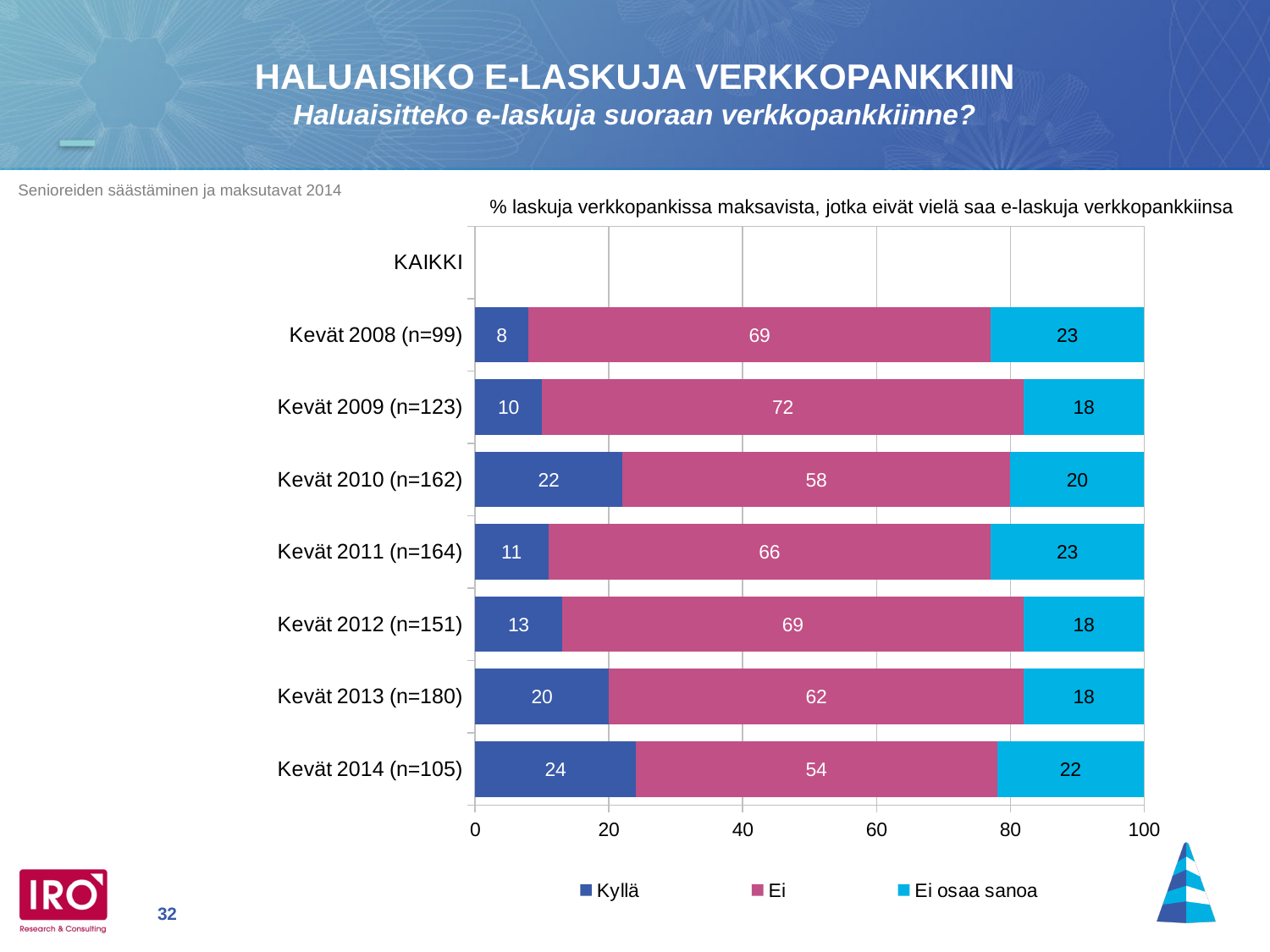
How many series does the legend list? 3 What is the Kyllä value for Kevät 2014 (n=105)? 24 Which year has the lowest Ei value? Kevät 2014 (n=105) Which year has the highest Kyllä value? Kevät 2014 (n=105) Which legend entry is shown in pink? Ei What is the total of the stacked bar for Kevät 2012 (n=151)? 100 What is the Ei osaa sanoa value for Kevät 2011 (n=164)? 23 How many years have a plotted bar in the chart? 7 What is the difference between the Ei values for Kevät 2009 (n=123) and Kevät 2014 (n=105)? 18 What is the Ei value for Kevät 2009 (n=123)? 72 Which is larger, the Kyllä value for Kevät 2010 (n=162) or for Kevät 2013 (n=180)? Kevät 2010 (n=162) What kind of chart is shown on the slide? Stacked bar chart